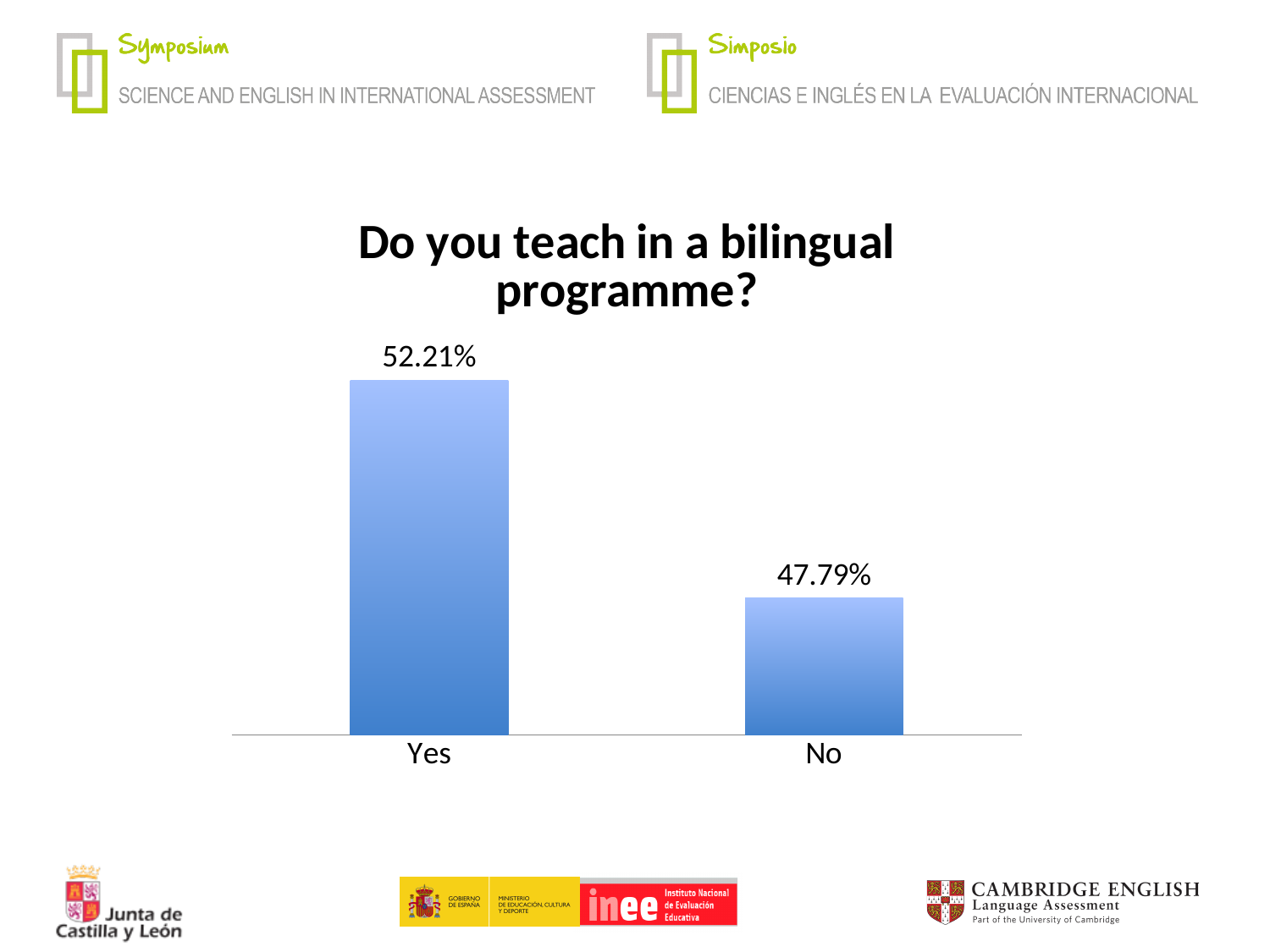
What colour are the bars in the chart? Blue Which response has the lower percentage, Yes or No? No What is the title of the chart? Do you teach in a bilingual programme? What kind of chart is shown on the slide? Bar chart Which response has the higher percentage, Yes or No? Yes What percentage of respondents answered No to "Do you teach in a bilingual programme?" 47.79% What percentage of respondents answered Yes to "Do you teach in a bilingual programme?" 52.21% What is the total of the Yes and No percentages shown in the chart? 100% What is the difference in percentage points between the Yes and No responses? 4.42 Is the value for Yes larger than the value for No? Yes How many response categories are shown in the chart? 2